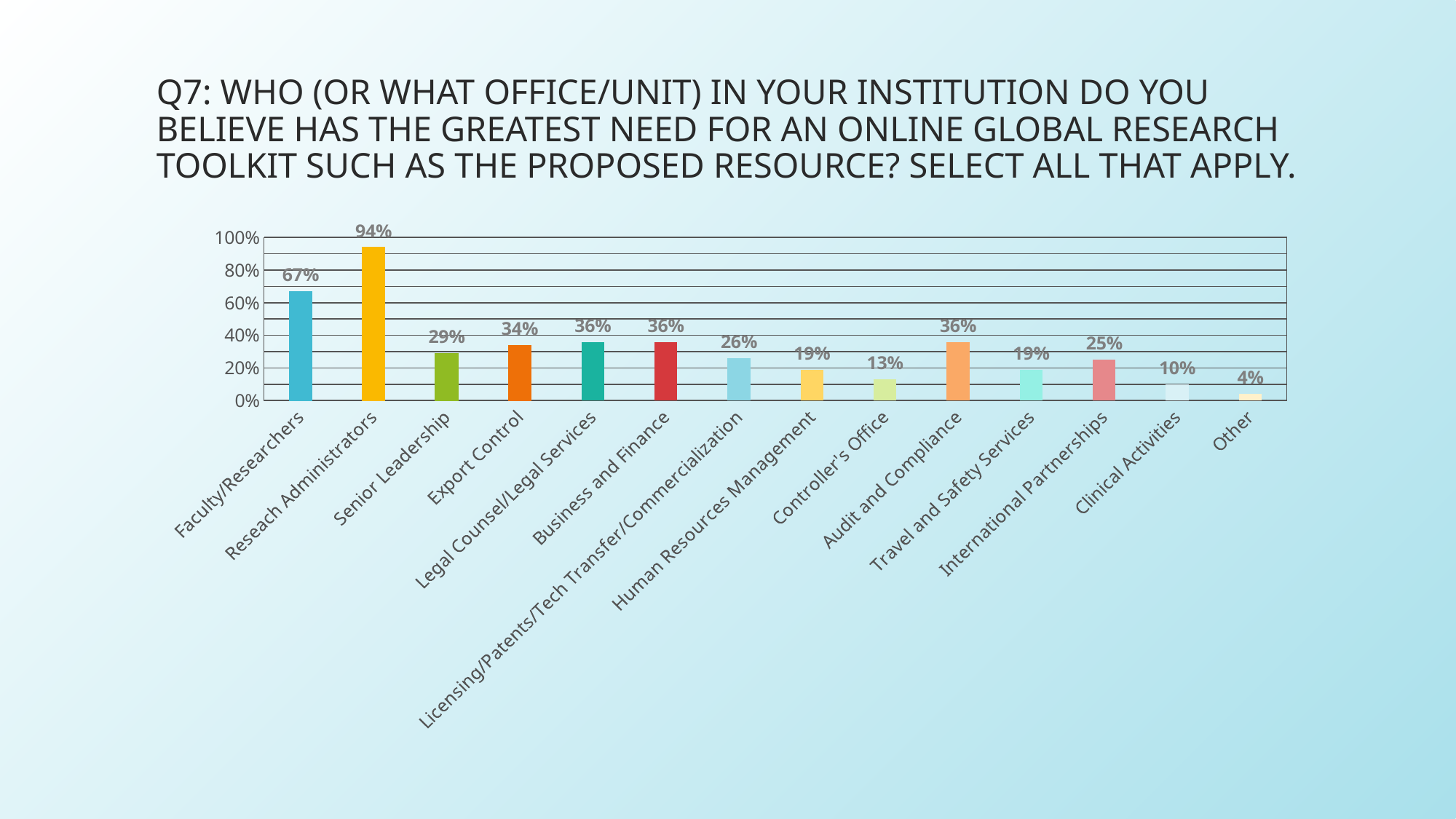
What is the difference between the values for Reseach Administrators and Faculty/Researchers? 27% Which is larger, the value for Senior Leadership or the value for International Partnerships? Senior Leadership Which category has the highest value? Reseach Administrators What kind of chart is shown on the slide? bar chart What is the value for Export Control? 34% What is the value for Faculty/Researchers? 67% Which category has the lowest value? Other What is the difference between the values for Audit and Compliance and Travel and Safety Services? 17% How many categories are shown on the x axis? 14 What is the value for Reseach Administrators? 94% What is the value for Controller's Office? 13% Is the value for Clinical Activities greater or less than 20%? less